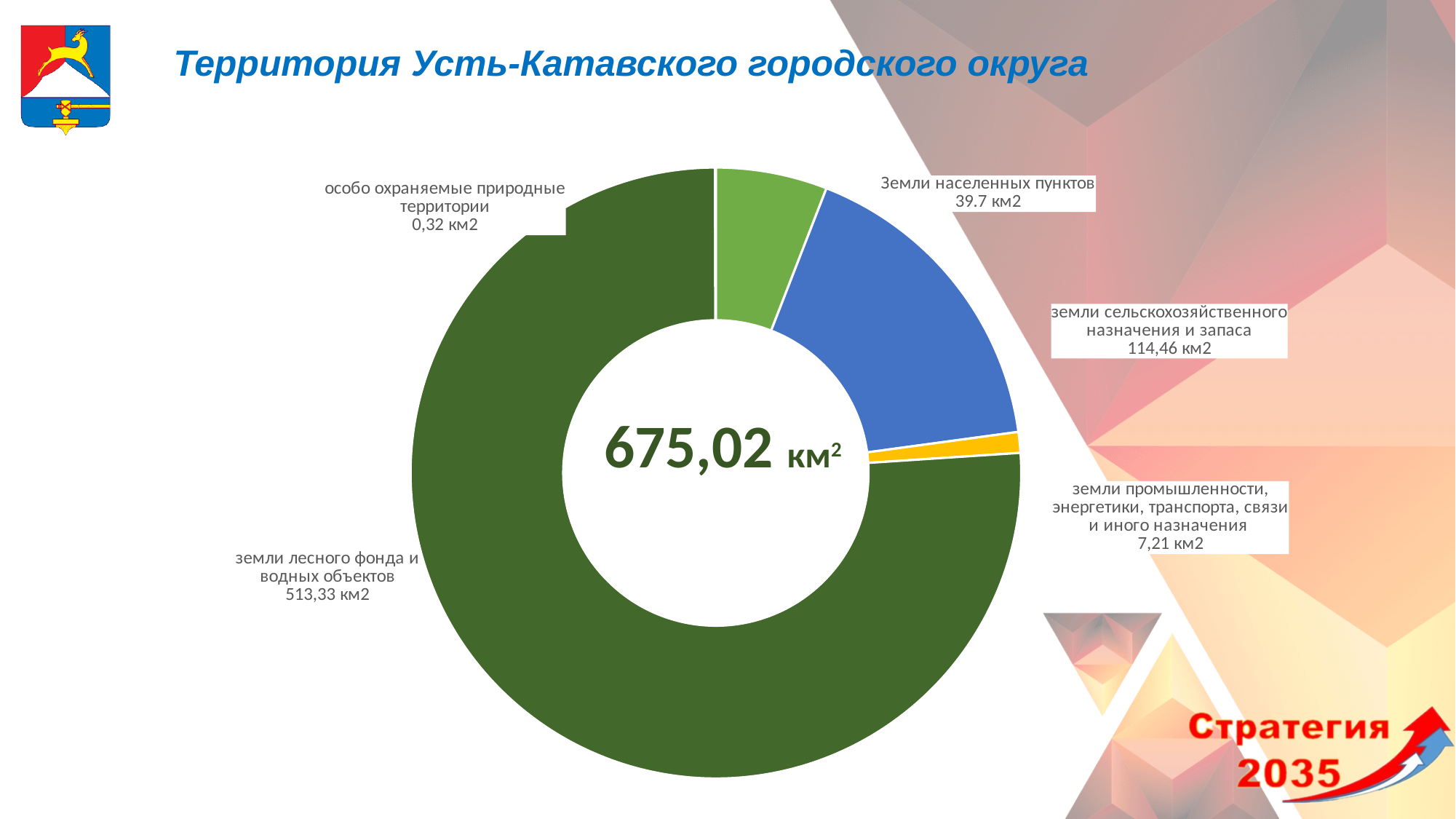
What is the difference between земли сельскохозяйственного назначения и запаса and Земли населенных пунктов? 74,76 км2 Which category has the largest area? земли лесного фонда и водных объектов What is the value for особо охраняемые природные территории? 0,32 км2 What is the value for земли промышленности, энергетики, транспорта, связи и иного назначения? 7,21 км2 How many categories does the chart show? 5 Which category has the smallest area? особо охраняемые природные территории What is the value for земли лесного фонда и водных объектов? 513,33 км2 What type of chart is shown on the slide? Donut (pie) chart What is the value for земли сельскохозяйственного назначения и запаса? 114,46 км2 Which is larger: Земли населенных пунктов or земли промышленности, энергетики, транспорта, связи и иного назначения? Земли населенных пунктов What total area is shown in the centre of the chart? 675,02 км2 What is the value for Земли населенных пунктов? 39.7 км2